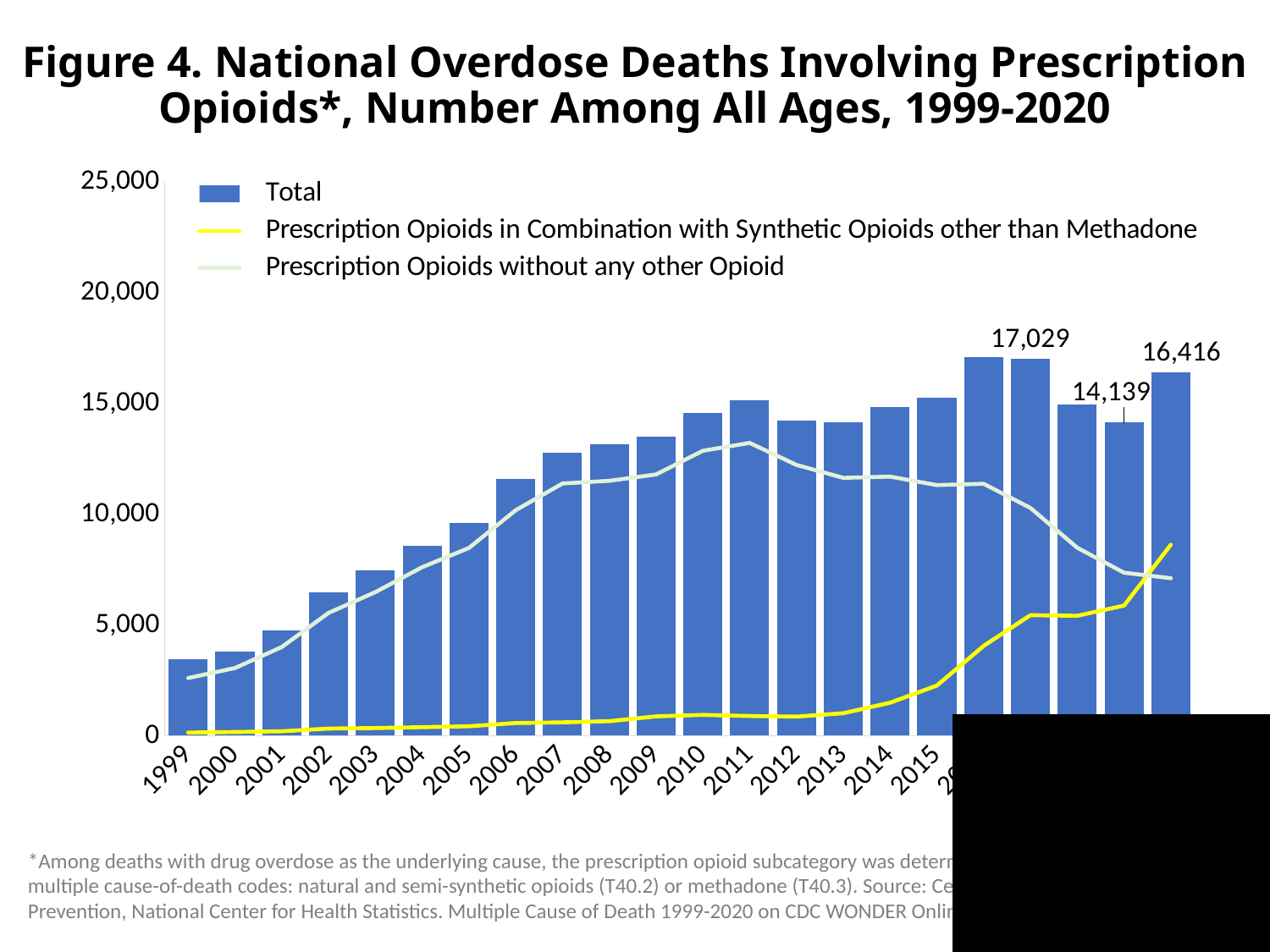
What is the value labeled on the second-to-last bar? 14,139 What is the difference between the labeled values 16,416 and 14,139? 2,277 What is the highest value printed as a data label on the chart? 17,029 What kind of chart is used to show the Total series? bar chart What is the value labeled on the rightmost bar? 16,416 Do the Total bars rise or fall from 1999 to 2011? rise What is the difference between the labeled values 17,029 and 16,416? 613 Which series is drawn as the yellow line? Prescription Opioids in Combination with Synthetic Opioids other than Methadone How many series does the legend list? 3 Is the Total value for 2010 greater or less than 10,000? greater Is the Total value for 1999 greater or less than 5,000? less Which is larger, the rightmost bar or the second-to-last bar? the rightmost bar